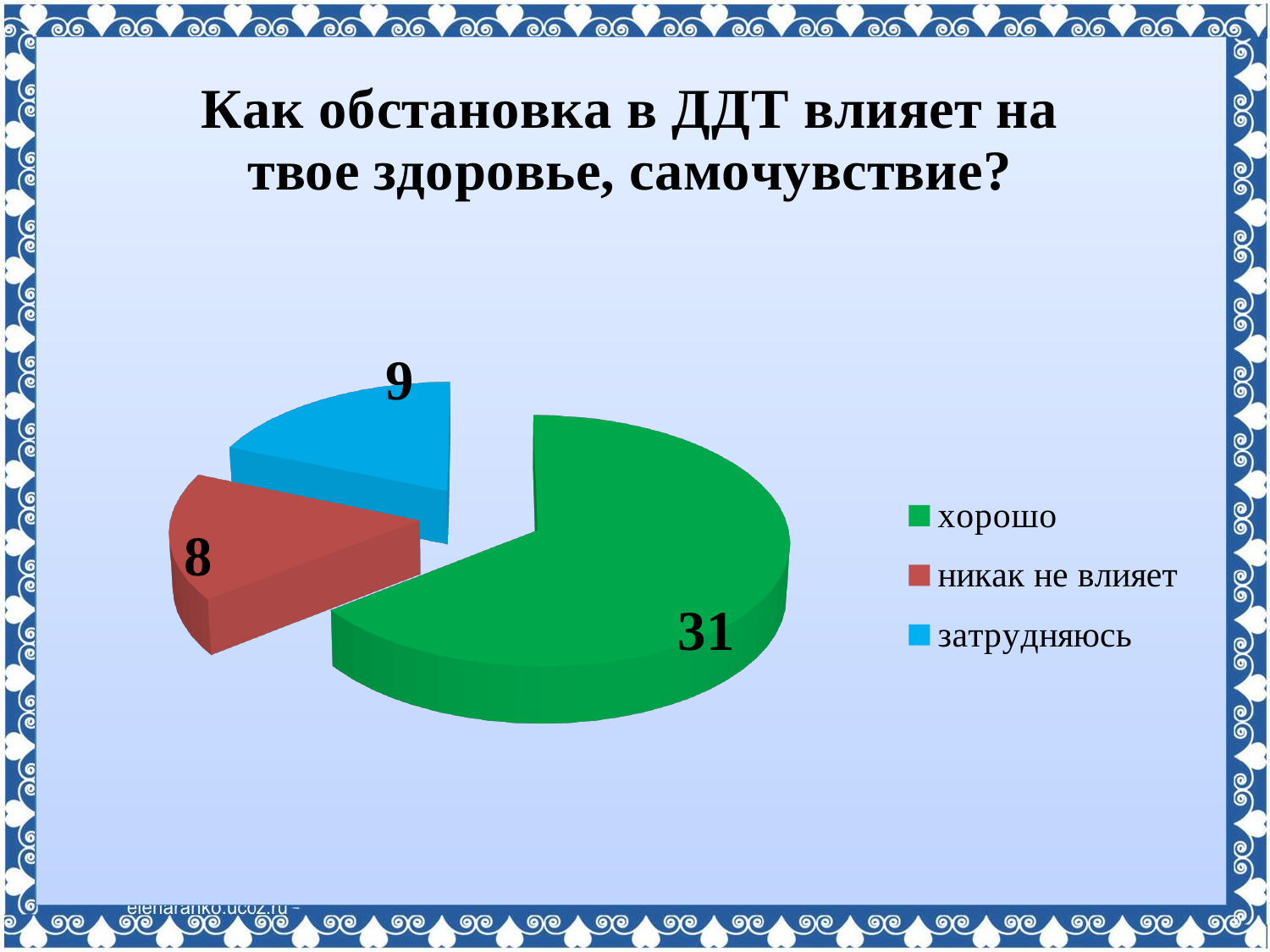
What is the value for the "затрудняюсь" slice? 9 Which category has the smallest slice of the pie? никак не влияет What colour is the "затрудняюсь" slice? blue What is the value for the "хорошо" slice? 31 Which category has the largest slice of the pie? хорошо What is the total of all the values shown in the pie chart? 48 How many slices does the pie chart have? 3 What is the difference between the values for "затрудняюсь" and "никак не влияет"? 1 What is the difference between the values for "хорошо" and "затрудняюсь"? 22 Which is larger, the value for "хорошо" or the value for "никак не влияет"? хорошо What is the value for the "никак не влияет" slice? 8 What kind of chart is shown on the slide? pie chart